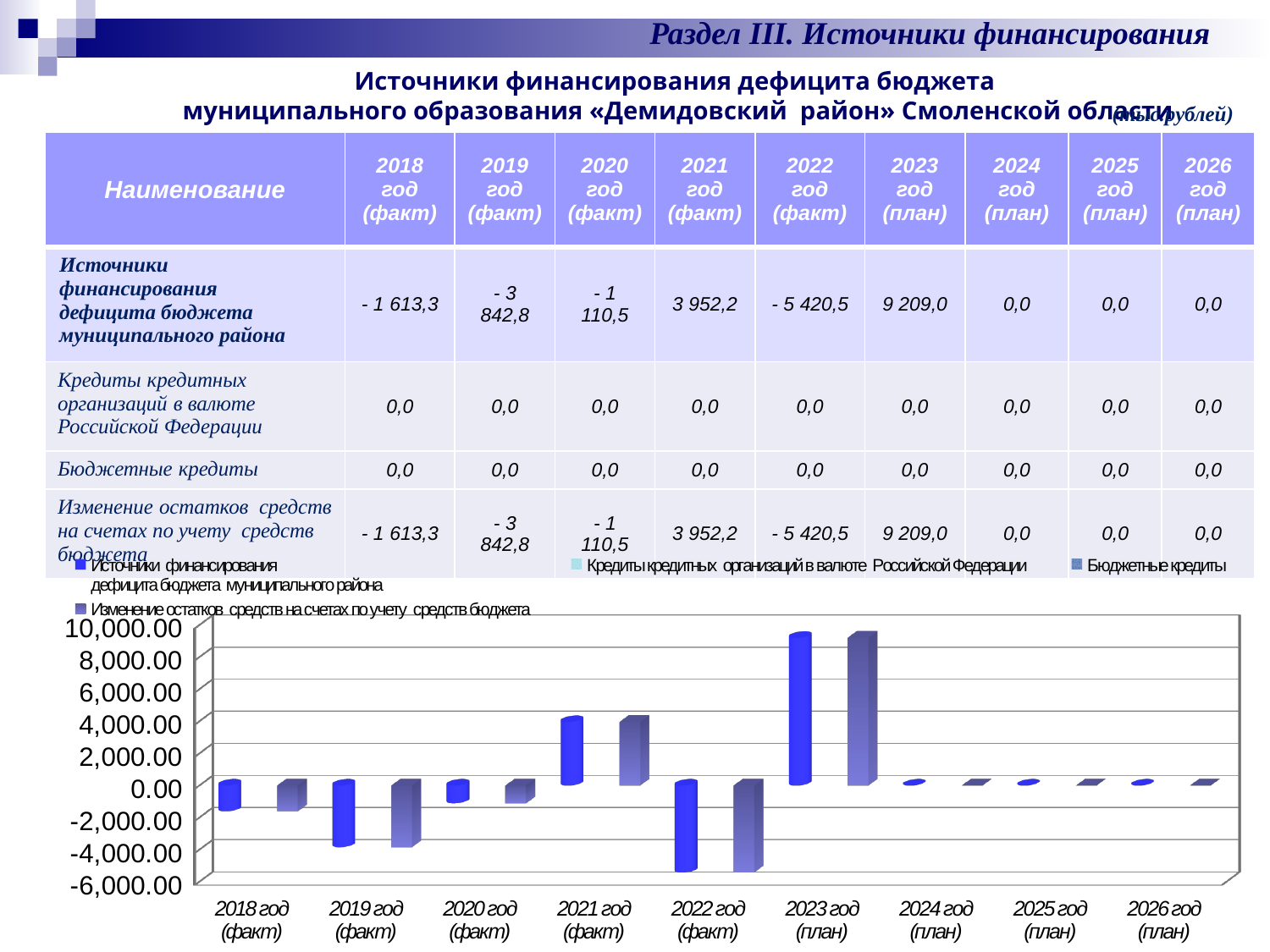
In the chart, is the value for 2021 год (факт) for Изменение остатков средств на счетах по учету средств бюджета greater or less than 2,000.00? greater Do the chart values for Источники финансирования дефицита бюджета муниципального района rise, fall or stay flat from 2024 год (план) to 2026 год (план)? stay flat In the chart, which year category has the lowest value for Источники финансирования дефицита бюджета муниципального района? 2022 год (факт) How many year categories are shown along the x axis of the chart? 9 In the chart, which is larger: the value for 2021 год (факт) or the value for 2023 год (план) for Источники финансирования дефицита бюджета муниципального района? 2023 год (план) According to the table on the slide, what is the value of Изменение остатков средств на счетах по учету средств бюджета for 2022 год (факт)? - 5 420,5 In the chart, is the value for 2022 год (факт) for Источники финансирования дефицита бюджета муниципального района greater or less than -4,000.00? less What kind of chart is shown at the bottom of the slide? bar chart According to the table on the slide, what is the value of Источники финансирования дефицита бюджета муниципального района for 2023 год (план)? 9 209,0 How many series does the chart legend list? 4 In the chart, is the value for 2023 год (план) for Источники финансирования дефицита бюджета муниципального района greater or less than 8,000.00? greater In the chart, which year category has the highest value for Источники финансирования дефицита бюджета муниципального района? 2023 год (план)